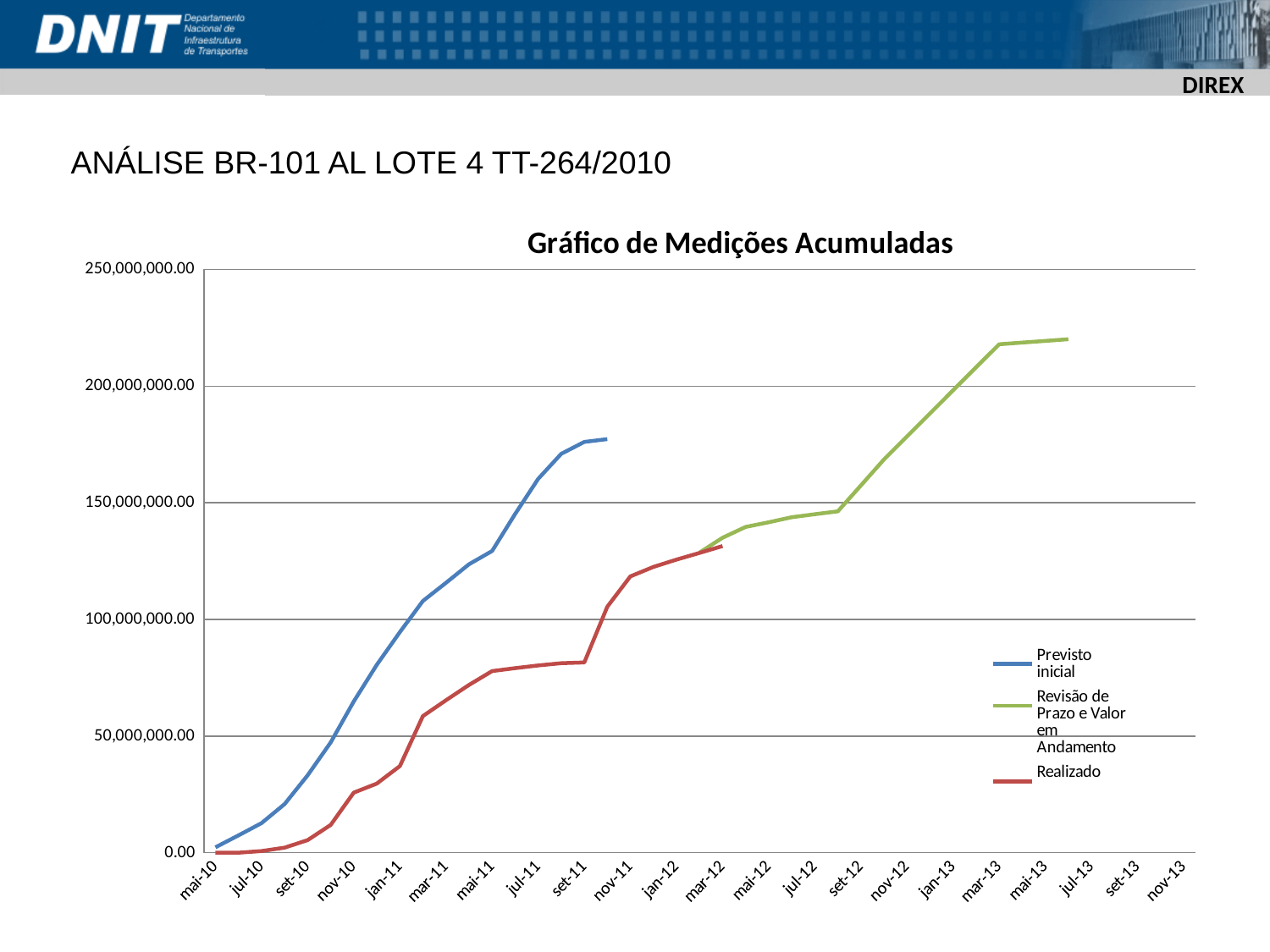
Is the value for Realizado at nov-11 greater or less than 100,000,000.00? greater Is the value for Realizado at set-11 greater or less than 100,000,000.00? less At set-11, which is larger: Previsto inicial or Realizado? Previsto inicial What is the title of the chart? Gráfico de Medições Acumuladas Which series reaches the highest value on the chart? Revisão de Prazo e Valor em Andamento Does the Previsto inicial series rise or fall along the x axis? rise Is the value for Previsto inicial at set-11 greater or less than 150,000,000.00? greater Which series extends furthest to the right along the x axis? Revisão de Prazo e Valor em Andamento What kind of chart is shown on the slide? line chart How many series does the legend list? 3